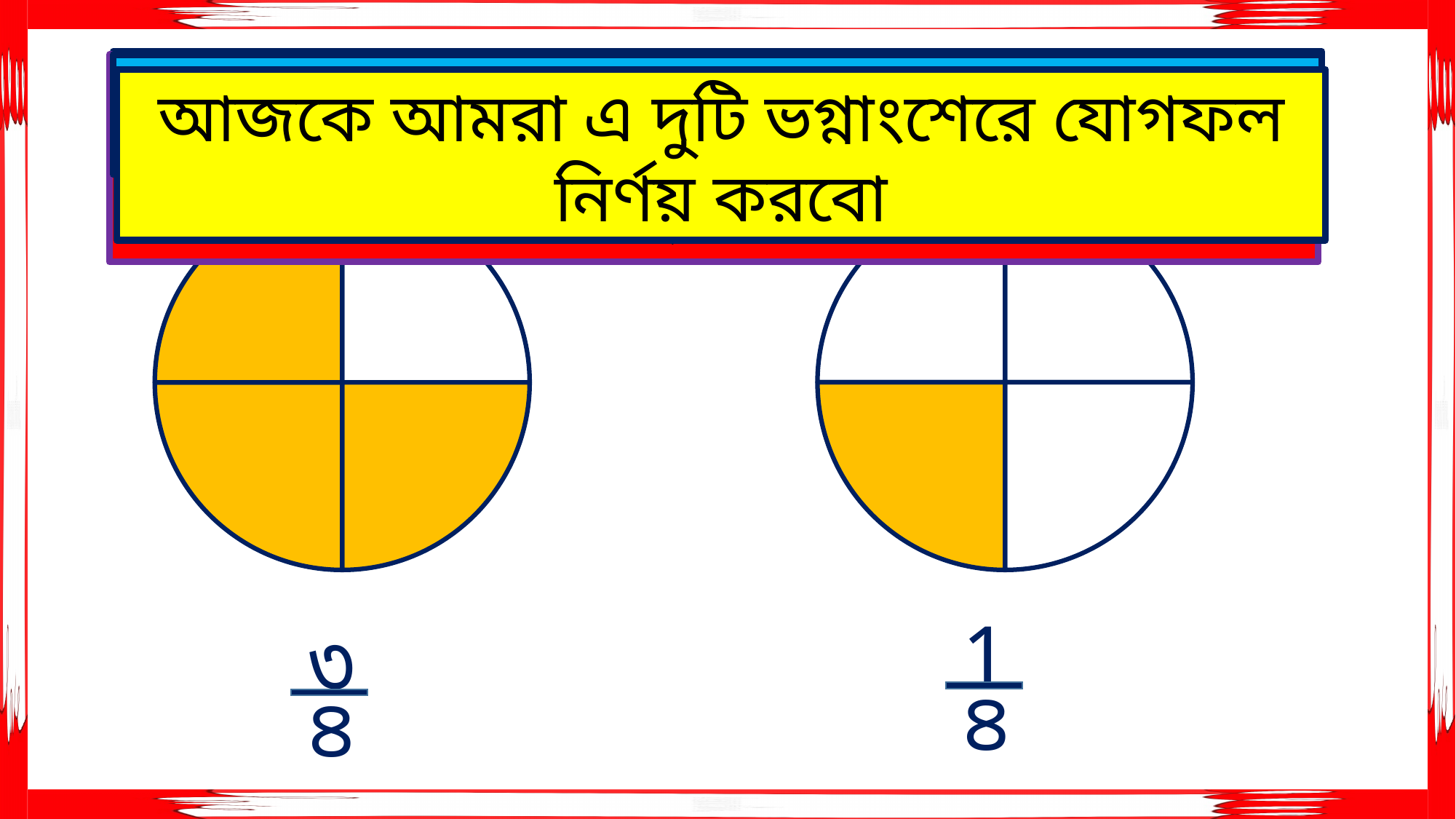
What fraction is written below the right circle? 1/৪ How many sections of the left circle are shaded? 3 How many equal sections is the left circle divided into? 4 What fraction is written below the left circle? ৩/৪ What share of the left circle is shaded? ৩/৪ What colour are the shaded sections of the circles? orange How many circle diagrams are shown on the slide? 2 What share of the right circle is shaded? ১/৪ How many sections of the right circle are shaded? 1 Which circle has the larger shaded share, the left or the right? left How many equal sections is the right circle divided into? 4